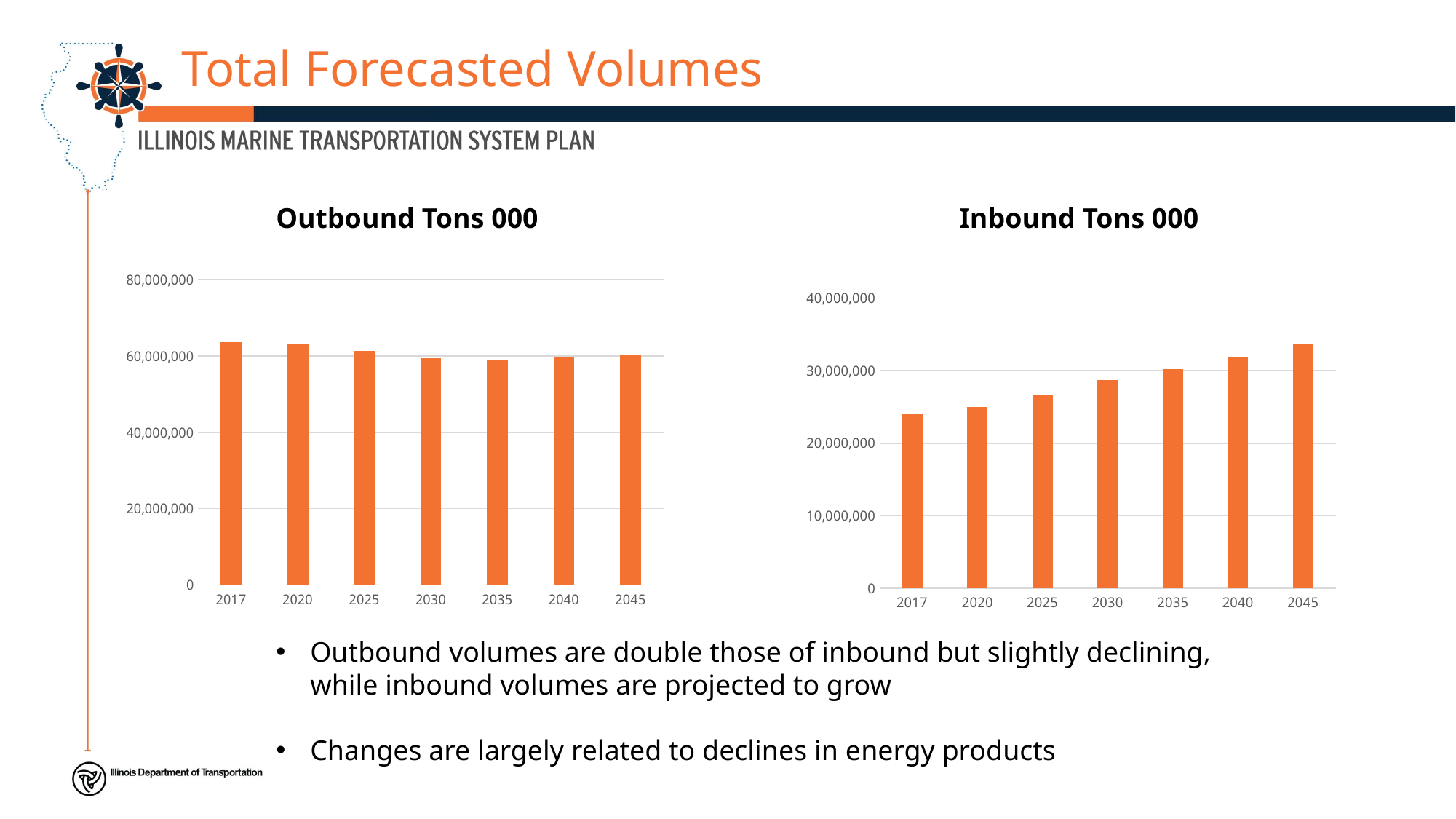
What is the title of the chart on the right side of the slide? Inbound Tons 000 In the Inbound Tons 000 chart, is the value for 2040 greater or less than 30,000,000? greater How many years are shown on the x axis of the Inbound Tons 000 chart? 7 In the Inbound Tons 000 chart, which year has the highest value? 2045 In the Inbound Tons 000 chart, which is larger, the value for 2017 or the value for 2045? 2045 In the Inbound Tons 000 chart, do the values rise or fall from 2017 to 2045? rise In the Inbound Tons 000 chart, is the value for 2017 greater or less than 30,000,000? less What kind of chart is the Outbound Tons 000 chart? bar chart In the Outbound Tons 000 chart, which is larger, the value for 2017 or the value for 2035? 2017 In the Inbound Tons 000 chart, which year has the lowest value? 2017 In the Outbound Tons 000 chart, which year has the highest value? 2017 In the Outbound Tons 000 chart, is the value for 2017 greater or less than 60,000,000? greater